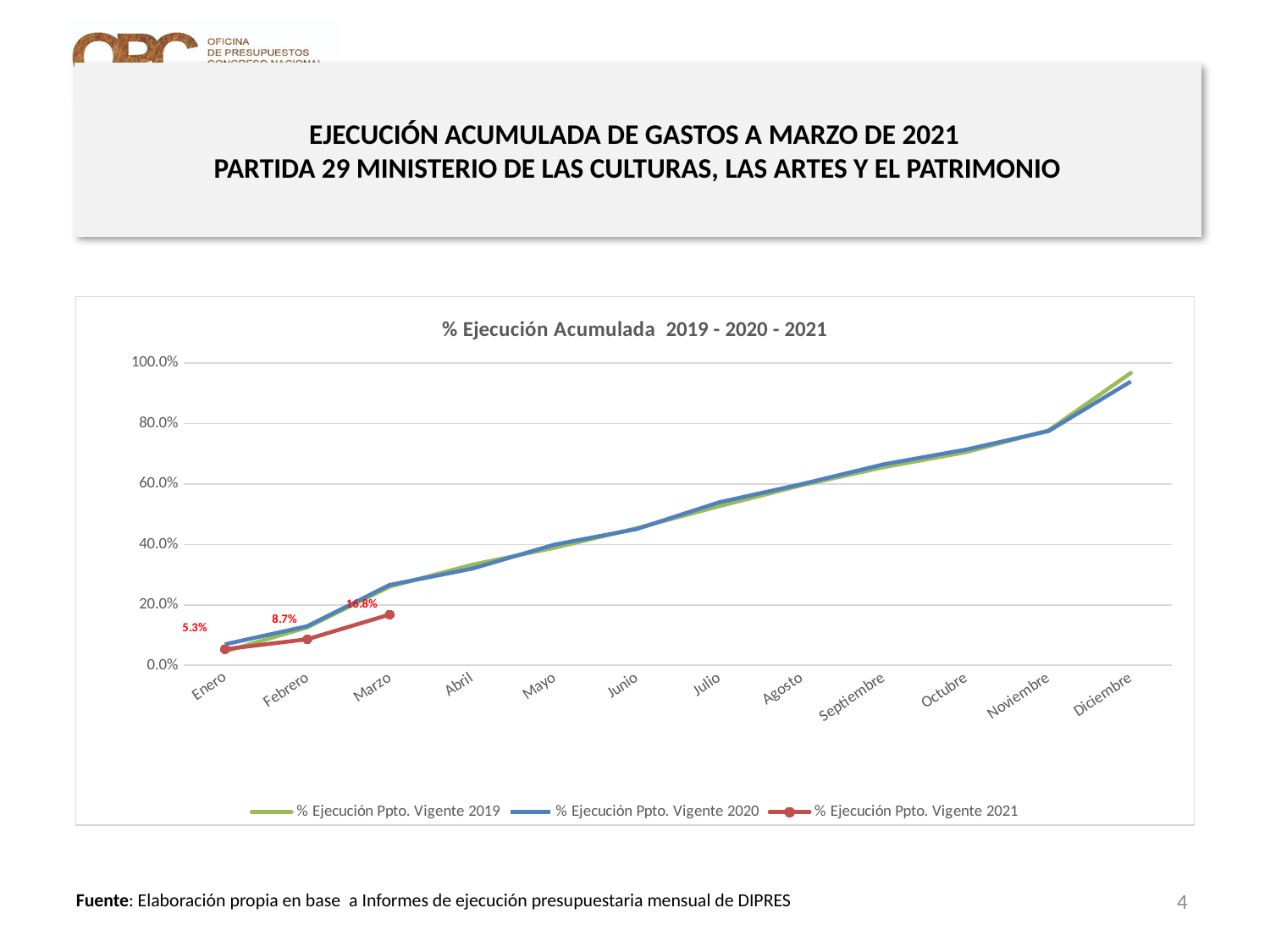
Is the value for Julio in the 2019 series greater or less than 60.0%? less How many series does the legend of the chart list? 3 What is the value for Enero in the % Ejecución Ppto. Vigente 2021 series? 5.3% Which is larger for Marzo: the 2020 series or the 2021 series? 2020 series What is the title of the chart? % Ejecución Acumulada 2019 - 2020 - 2021 How many months are shown along the x axis of the chart? 12 What is the value for Marzo in the % Ejecución Ppto. Vigente 2021 series? 16.8% By how many percentage points does the 2021 series increase from Enero to Febrero? 3.4 percentage points What kind of chart is shown on the slide? line chart What is the value for Febrero in the % Ejecución Ppto. Vigente 2021 series? 8.7% Is the value for Diciembre in the 2020 series greater or less than 80.0%? greater Do the values of the % Ejecución Ppto. Vigente 2020 series rise or fall from Enero to Diciembre? rise